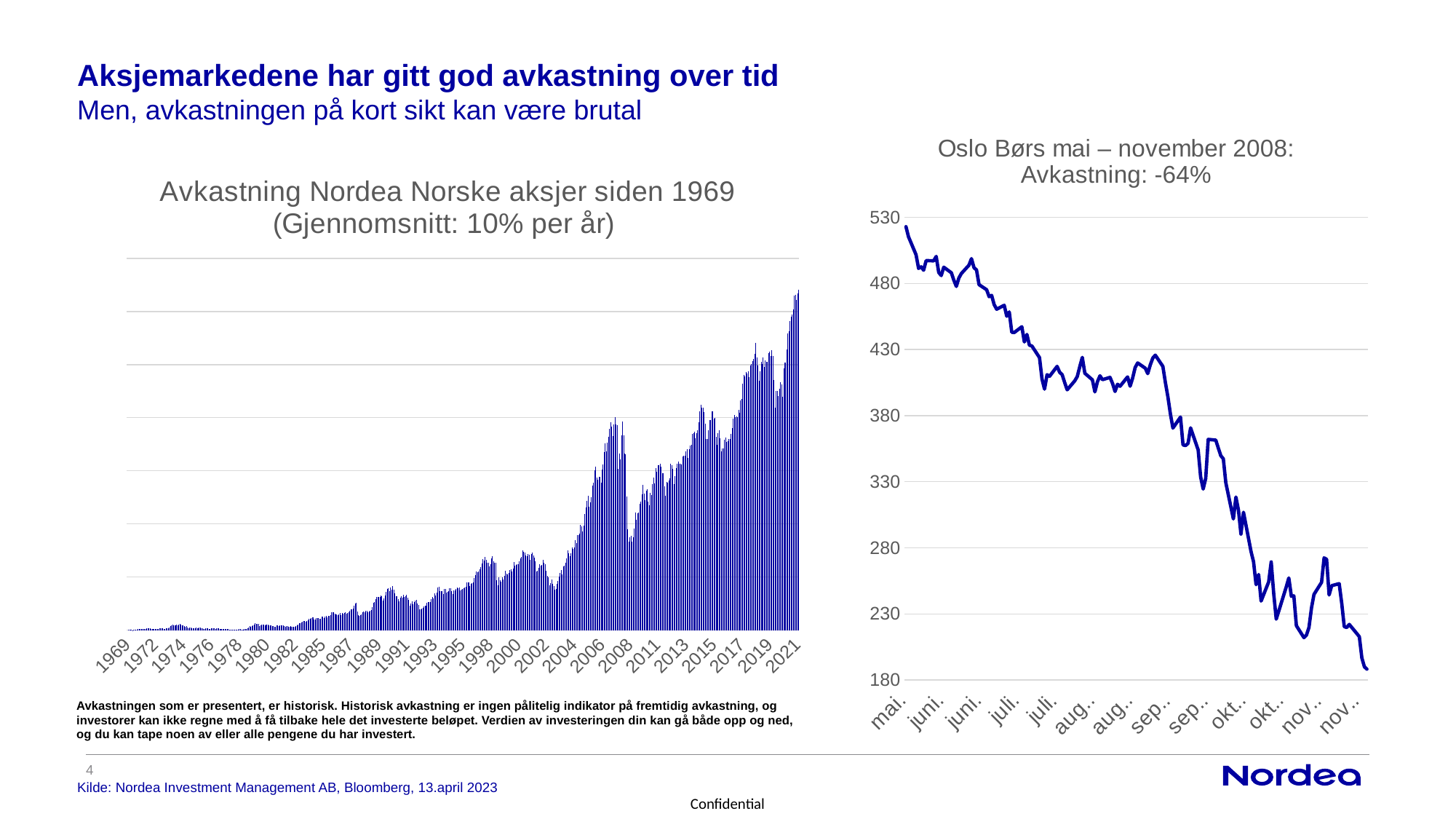
In the left chart 'Avkastning Nordea Norske aksjer siden 1969', do the values overall rise or fall from 1969 to 2021? rise In the right chart 'Oslo Børs mai – november 2008', do the values rise or fall from mai to november? fall According to the title of the right chart, what was the return on Oslo Børs from mai to november 2008? -64% In the right chart 'Oslo Børs mai – november 2008', is the value at the first 'aug.' label greater or less than 380? greater What kind of chart is the right chart titled 'Oslo Børs mai – november 2008'? line chart In the left chart 'Avkastning Nordea Norske aksjer siden 1969', which year label has the highest bars? 2021 What kind of chart is the left chart titled 'Avkastning Nordea Norske aksjer siden 1969'? bar chart In the right chart 'Oslo Børs mai – november 2008', is the value at the end of november greater or less than 230? less In the right chart 'Oslo Børs mai – november 2008', is the value at the start of mai greater or less than 480? greater In the right chart 'Oslo Børs mai – november 2008', what is the lowest value shown on the y axis? 180